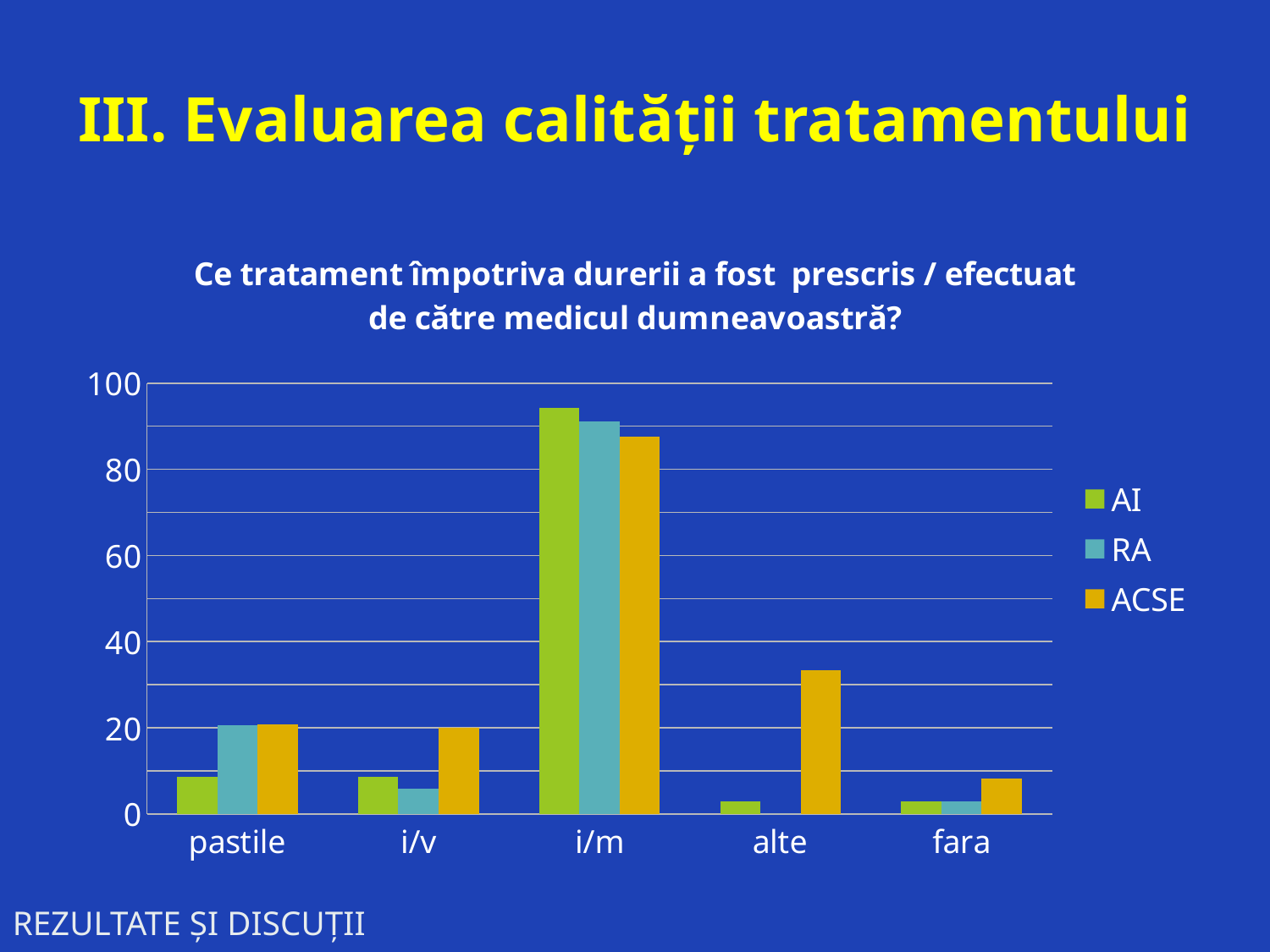
Which category has the highest value for the AI series? i/m Is the value for ACSE in the alte category greater or less than 20? greater What are the three series listed in the chart's legend? AI, RA, ACSE Is the value for AI in the pastile category greater or less than 20? less In the pastile category, which series has the larger value, AI or RA? RA What kind of chart is shown on the slide? bar chart How many series does the chart's legend list? 3 Is the value for AI in the i/m category greater or less than 80? greater Which category has the lowest value for the ACSE series? fara In the alte category, which series has the larger value, AI or ACSE? ACSE How many categories are shown on the x axis of the chart? 5